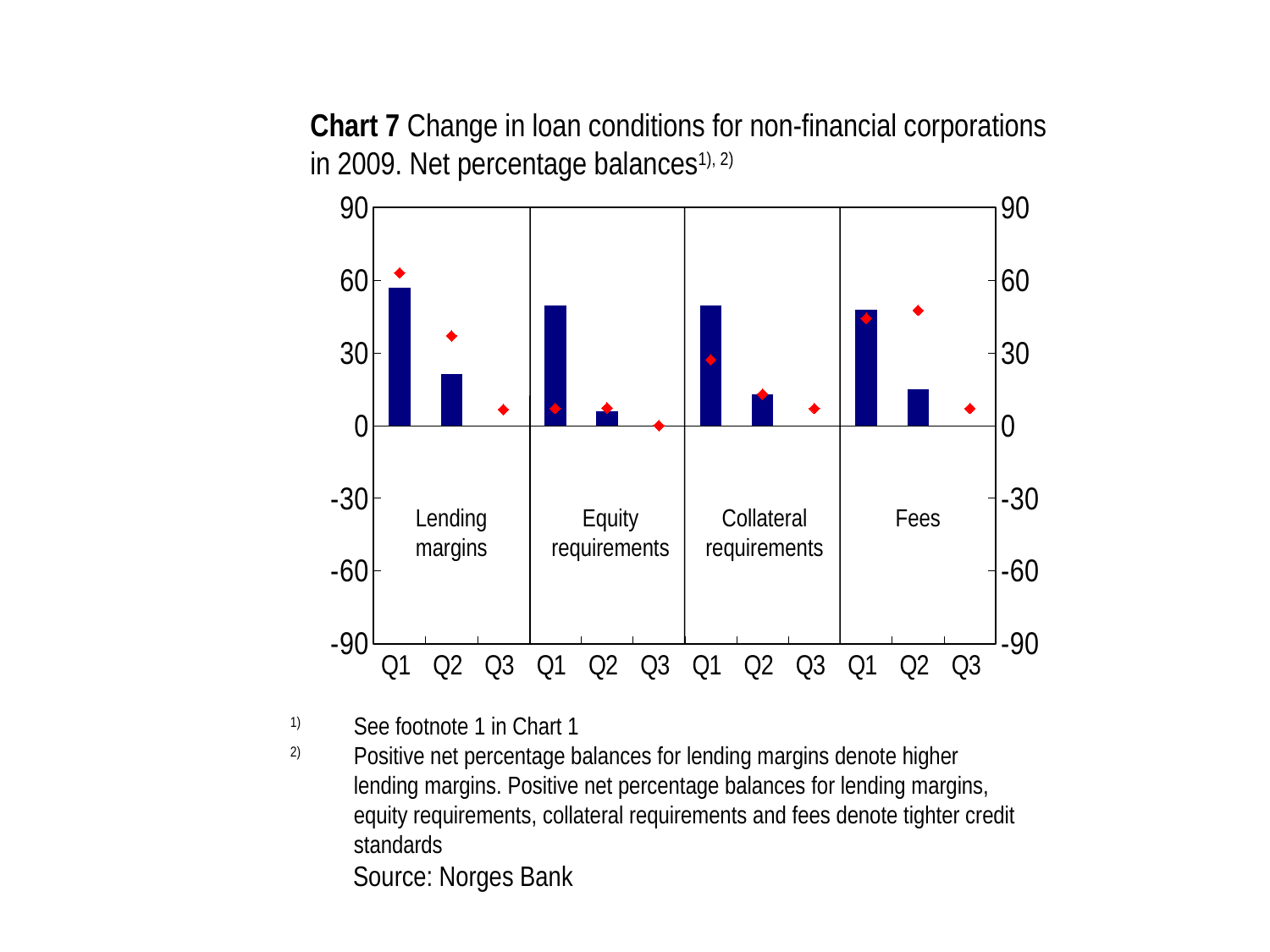
What kind of chart is shown on the slide? bar chart How many loan condition categories (panels) are shown in the chart? 4 Which quarter has the tallest bar in the Lending margins panel? Q1 Which is larger, the Q2 bar for Lending margins or the Q2 bar for Equity requirements? Lending margins Is the Q1 bar for Collateral requirements greater or less than 60? less What is the source given for the chart? Norges Bank What is the highest value shown on the vertical axis? 90 Is the Q2 bar for Equity requirements greater or less than 30? less Is the Q1 bar for Lending margins greater or less than 30? greater Which quarter has the tallest bar in the Fees panel? Q1 Do the bars rise or fall from Q1 to Q3 within each panel? fall